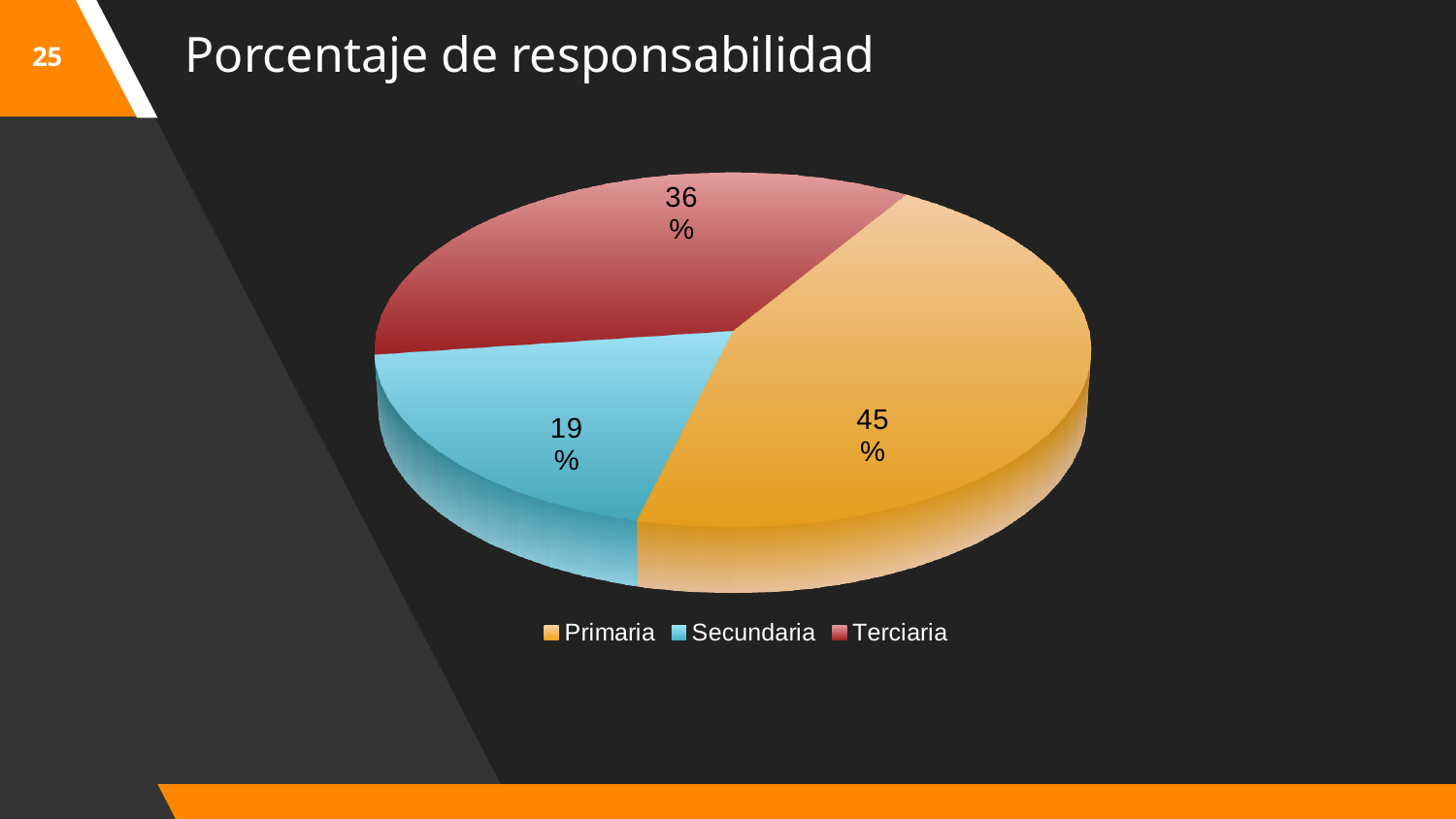
What colour represents Secundaria in the pie chart? Blue What is the value for Primaria? 45% What is the title of the chart slide? Porcentaje de responsabilidad Which category has the smallest share of the pie? Secundaria What is the value for Terciaria? 36% What type of chart is shown on the slide? Pie chart Which is larger, Secundaria or Terciaria? Terciaria What is the difference between the Primaria and Terciaria values? 9% Which category has the largest share of the pie? Primaria What is the difference between the Terciaria and Secundaria values? 17% How many categories does the pie chart have? 3 What is the value for Secundaria? 19%